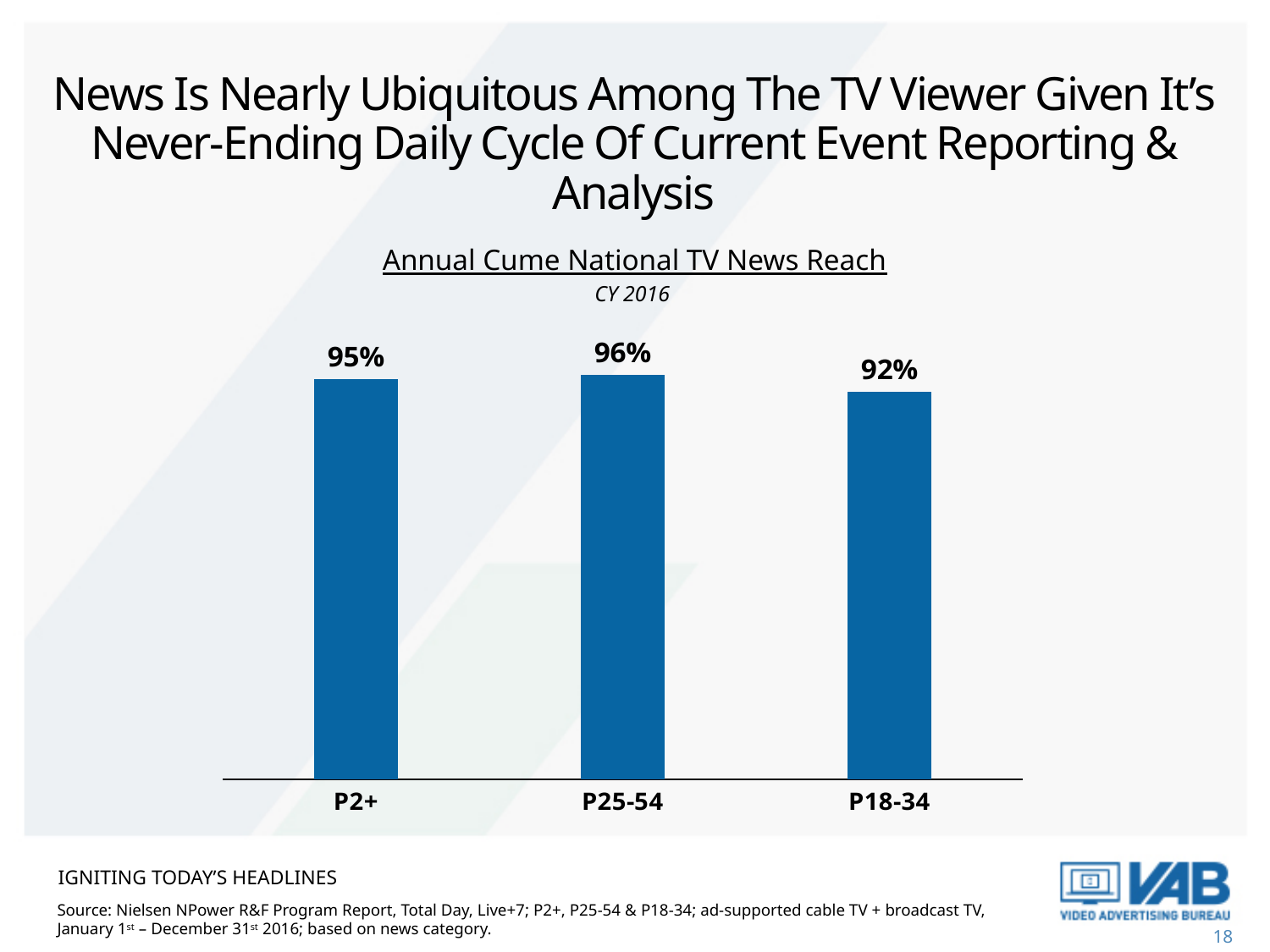
How many demographic categories are shown in the chart? 3 Which demographic has the highest annual cume national TV news reach? P25-54 Which has a higher news reach, P2+ or P18-34? P2+ What is the annual cume national TV news reach for P18-34? 92% Which demographic has the lowest annual cume national TV news reach? P18-34 What is the difference in news reach between P25-54 and P18-34? 4 percentage points What is the difference in news reach between P2+ and P18-34? 3 percentage points What is the title of the chart? Annual Cume National TV News Reach What is the annual cume national TV news reach for P25-54? 96% What is the annual cume national TV news reach for P2+? 95% What type of chart is used to show annual cume national TV news reach? Bar chart What time period does the chart cover, as shown in its subtitle? CY 2016